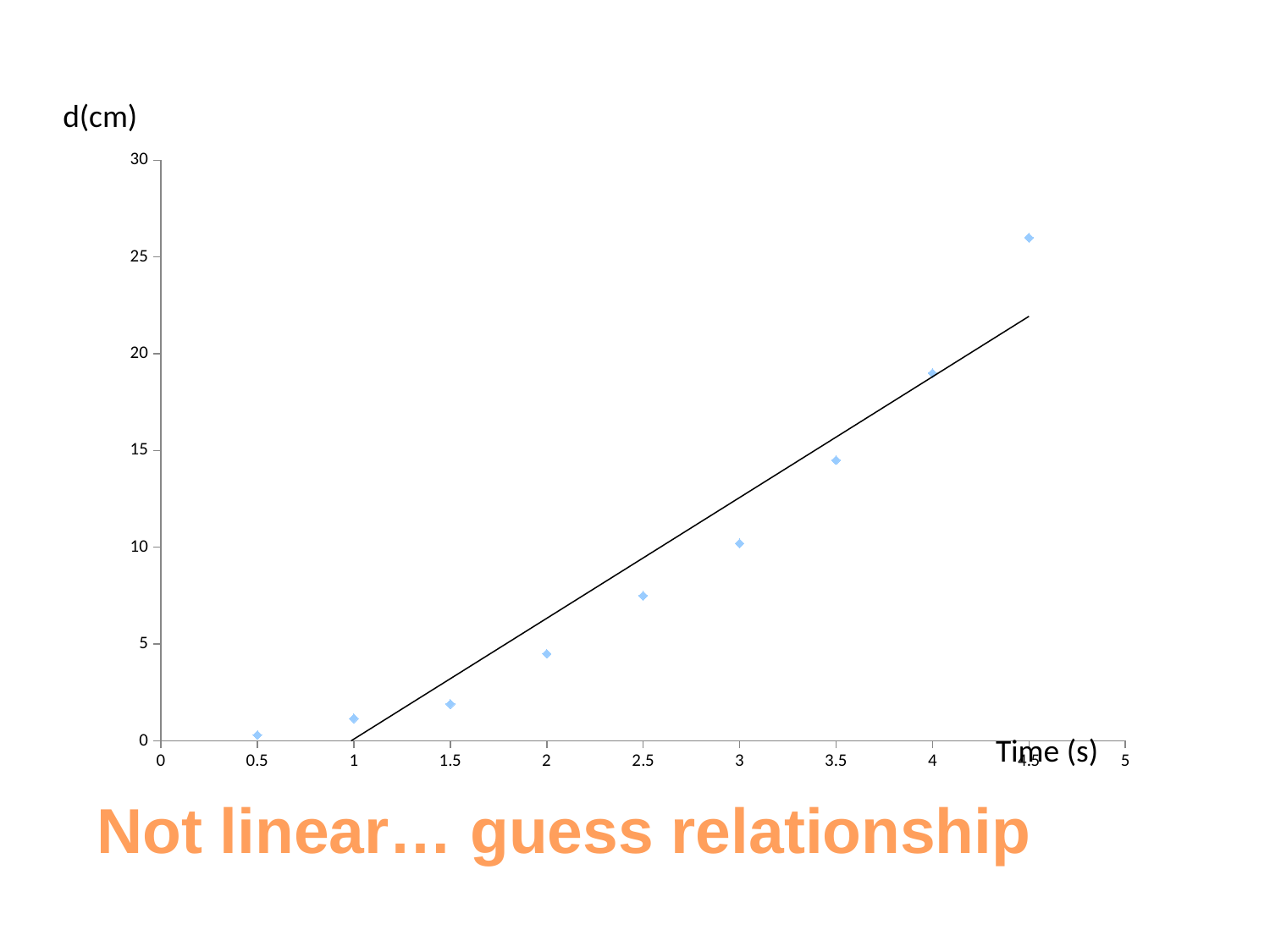
Which has the larger plotted value, time 2 or time 3? 3 At which time value is the plotted distance highest? 4.5 At which time value is the plotted distance lowest? 0.5 Is the value for time 4.5 greater or less than 25? greater Is the value for time 2.5 greater or less than 5? greater Is the value for time 4 greater or less than 20? less What kind of chart is shown on the slide? scatter plot Do the plotted values rise or fall as time increases along the x axis? rise How many data points are plotted on the chart? 9 What is the label on the horizontal axis of the chart? Time (s) What is the label on the vertical axis of the chart? d(cm)